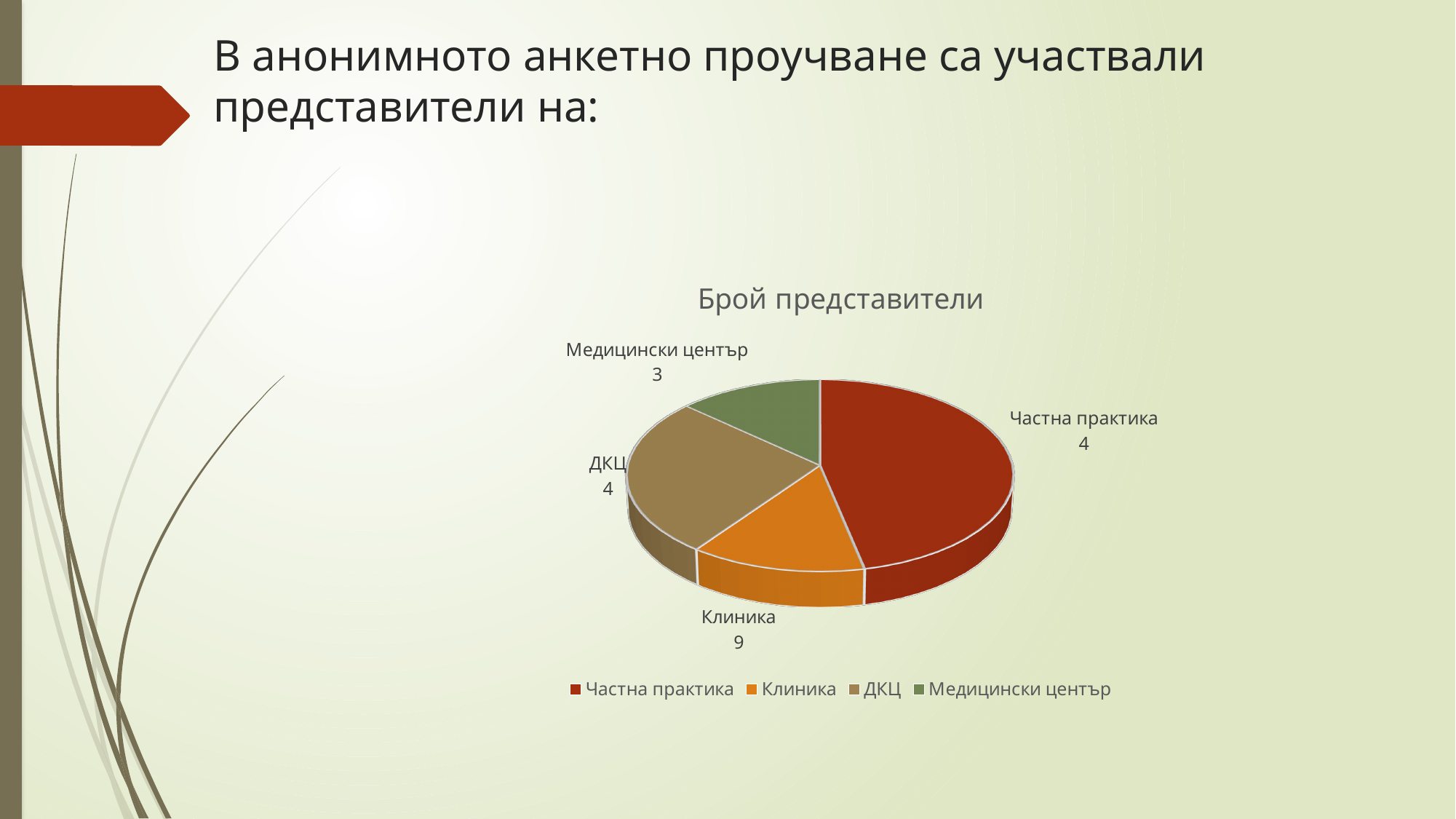
What is the value for Частна практика in the pie chart? 4 Which is larger, the value for ДКЦ or the value for Медицински център? ДКЦ How many categories (slices) does the pie chart have? 4 What is the title of the chart? Брой представители What is the value for ДКЦ in the pie chart? 4 What kind of chart is shown on the slide? Pie chart What is the total of all values shown in the pie chart? 20 What is the value for Медицински център in the pie chart? 3 How many entries does the legend of the chart list? 4 What is the value for Клиника in the pie chart? 9